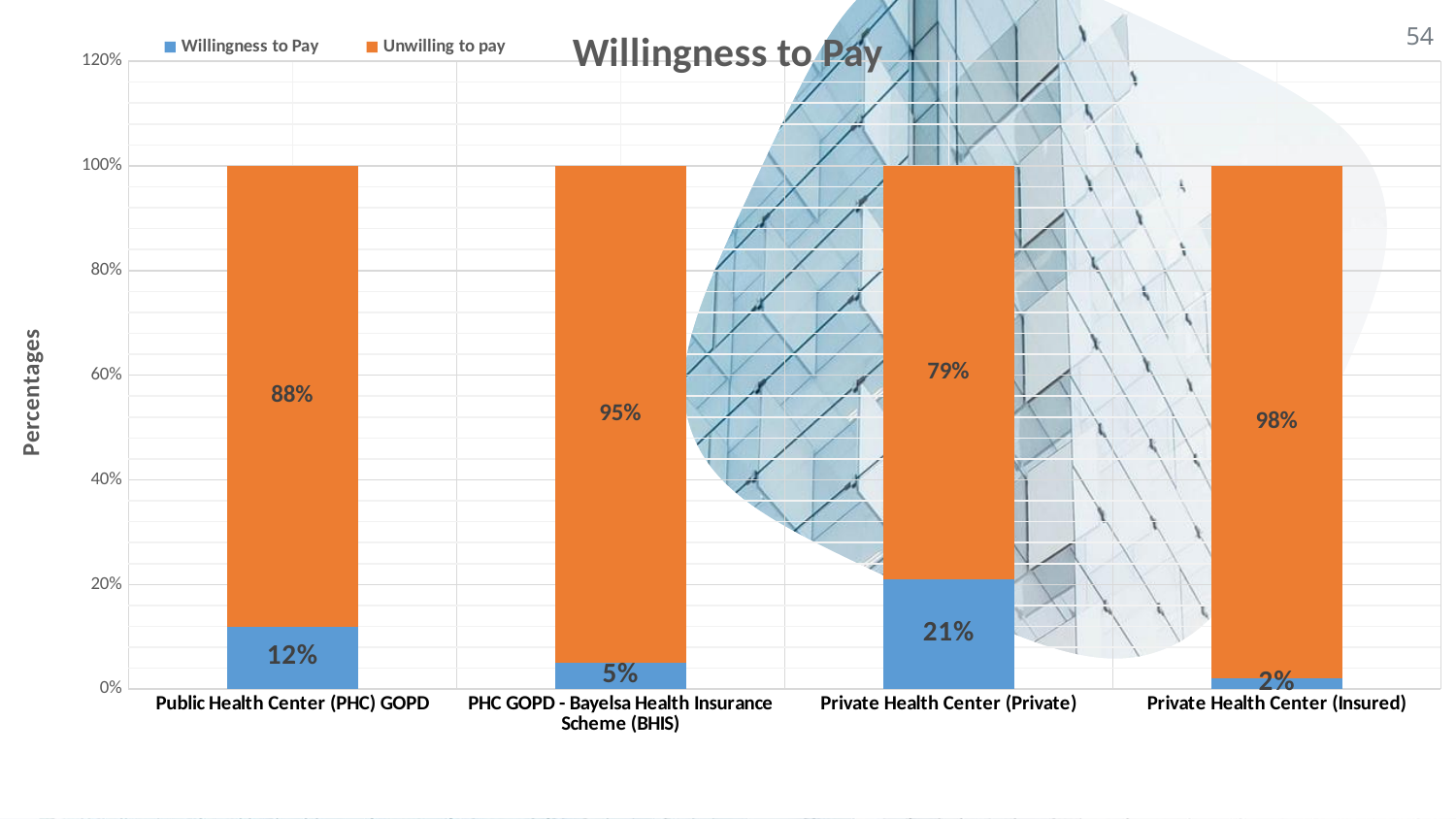
What is the difference between the Unwilling to pay values for Private Health Center (Insured) and Private Health Center (Private)? 19% What is the total of the stacked bar for Private Health Center (Private)? 100% What is the Unwilling to pay value for PHC GOPD - Bayelsa Health Insurance Scheme (BHIS)? 95% Which category has the highest Unwilling to pay value? Private Health Center (Insured) What is the Willingness to Pay value for Public Health Center (PHC) GOPD? 12% Which is larger: the Willingness to Pay value for Public Health Center (PHC) GOPD or for PHC GOPD - Bayelsa Health Insurance Scheme (BHIS)? Public Health Center (PHC) GOPD Which category has the lowest Willingness to Pay value? Private Health Center (Insured) What kind of chart is shown on the slide? Stacked bar chart How many categories are shown on the x axis? 4 What is the Willingness to Pay value for Private Health Center (Private)? 21% How many series does the legend list? 2 Which category has the highest Willingness to Pay value? Private Health Center (Private)